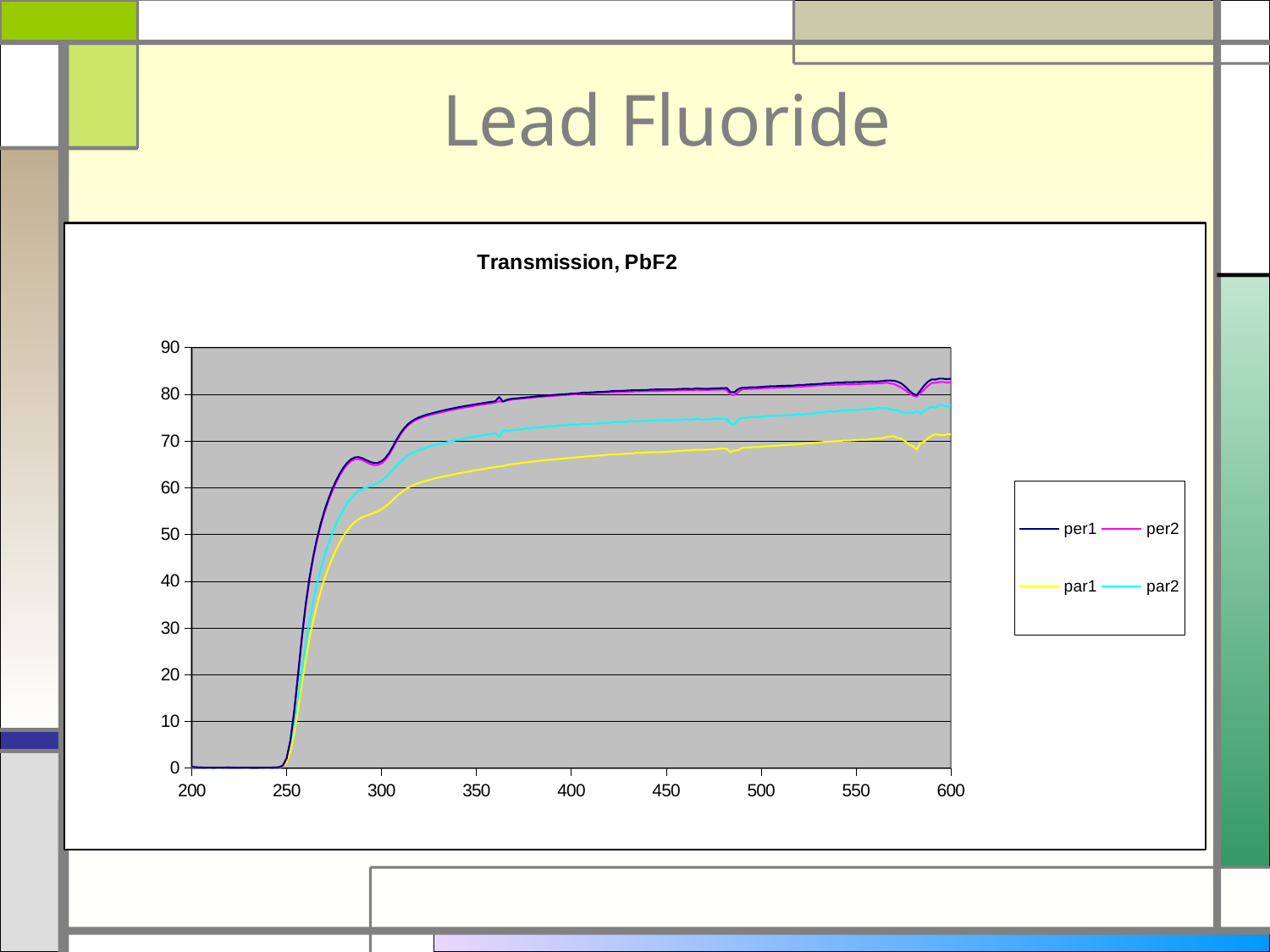
Do the transmission values generally rise or fall as the x axis goes from 200 to 600? rise Is the value of par1 at x = 600 greater or less than 80? less Is the value of per1 at x = 200 greater or less than 10? less At x = 500, which is larger, per1 or par1? per1 Is the value of per1 at x = 400 greater or less than 70? greater What is the title of the chart on the slide? Transmission, PbF2 Which series are listed in the legend of the chart? per1, per2, par1, par2 At x = 400, which is larger, par2 or par1? par2 What kind of chart is shown under the title "Transmission, PbF2"? line chart Which series has the lowest value at x = 600? par1 How many series does the legend of the Transmission, PbF2 chart list? 4